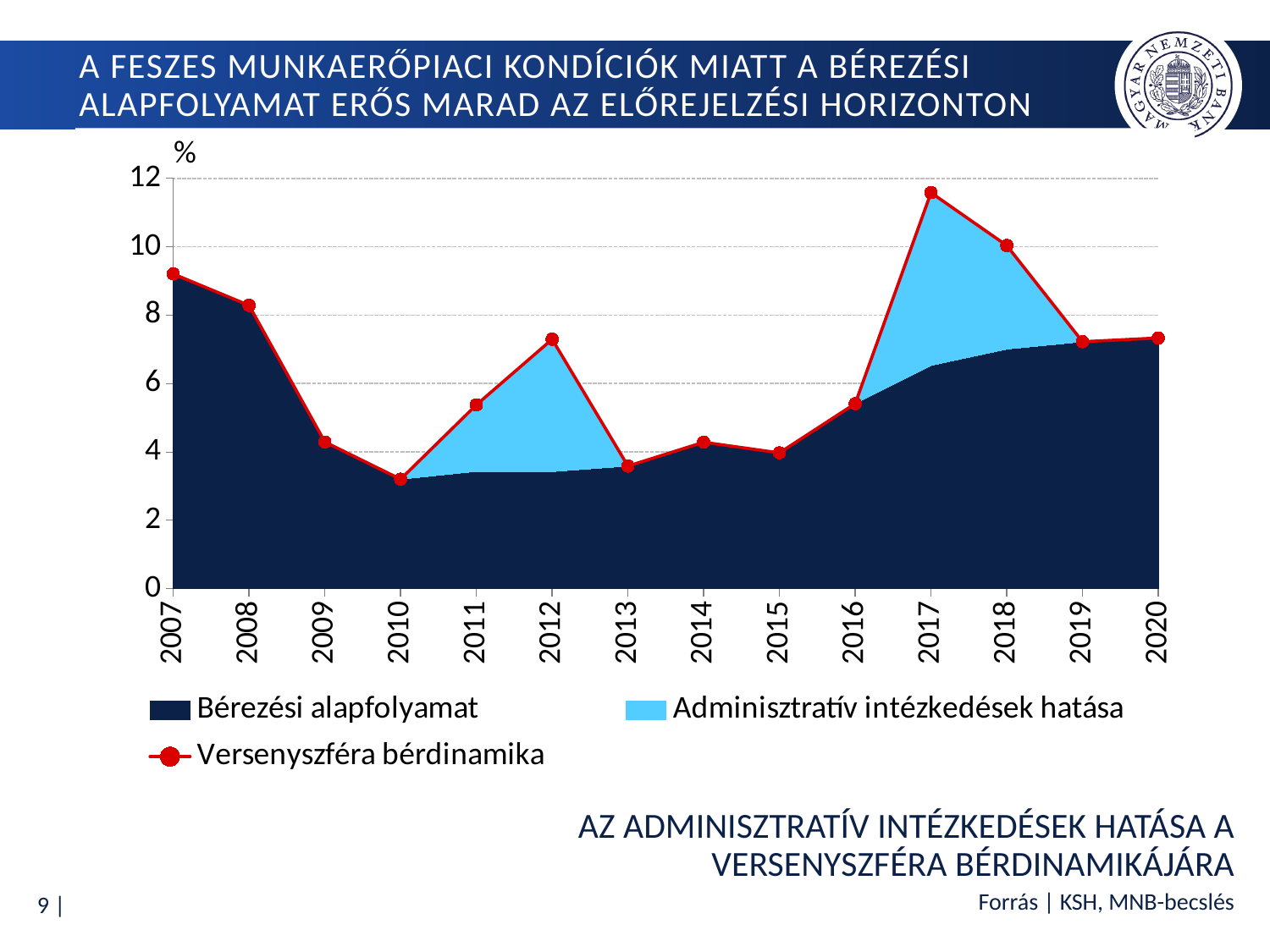
Is the Versenyszféra bérdinamika value for 2017 greater or less than 10? greater Is the Versenyszféra bérdinamika value for 2010 greater or less than 4? less Does the Versenyszféra bérdinamika line rise or fall from 2007 to 2010? fall How many years are shown on the x axis? 14 Which year has the higher Versenyszféra bérdinamika value, 2012 or 2016? 2012 In which year is the Versenyszféra bérdinamika line at its highest? 2017 How many series does the legend list? 3 What unit is shown at the top of the y axis? % In which year is the Versenyszféra bérdinamika line at its lowest? 2010 Is the Versenyszféra bérdinamika value for 2007 greater or less than 8? greater What kind of chart is this? Stacked area chart with a line